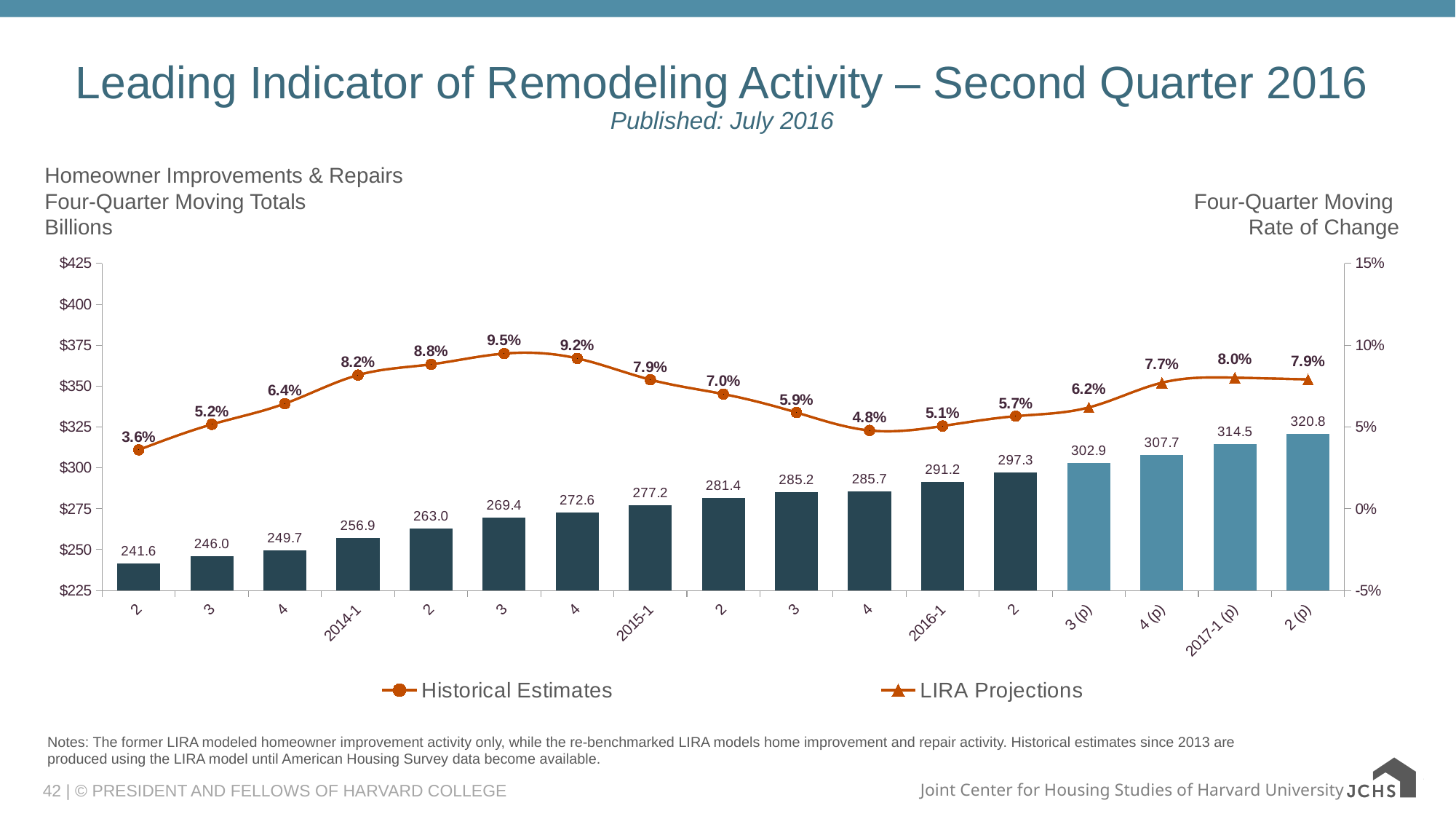
How many series does the legend list? 2 What is the difference between the four-quarter moving totals for 2017-1 (p) and 2016-1? 23.3 What is the lowest four-quarter moving rate of change shown on the line? 3.6% What is the four-quarter moving rate of change for 2015-1? 7.9% What is the highest four-quarter moving rate of change shown on the line? 9.5% What kind of chart is this? Combination bar and line chart How many periods (bars) are shown on the chart? 17 What is the four-quarter moving total (in billions) for 2016-1? 291.2 Which has a larger four-quarter moving total, 2014-1 or 2015-1? 2015-1 What is the projected four-quarter moving total for 2017-1 (p)? 314.5 Do the four-quarter moving totals (bars) rise or fall from left to right? Rise Which period has the highest four-quarter moving total? 2 (p)